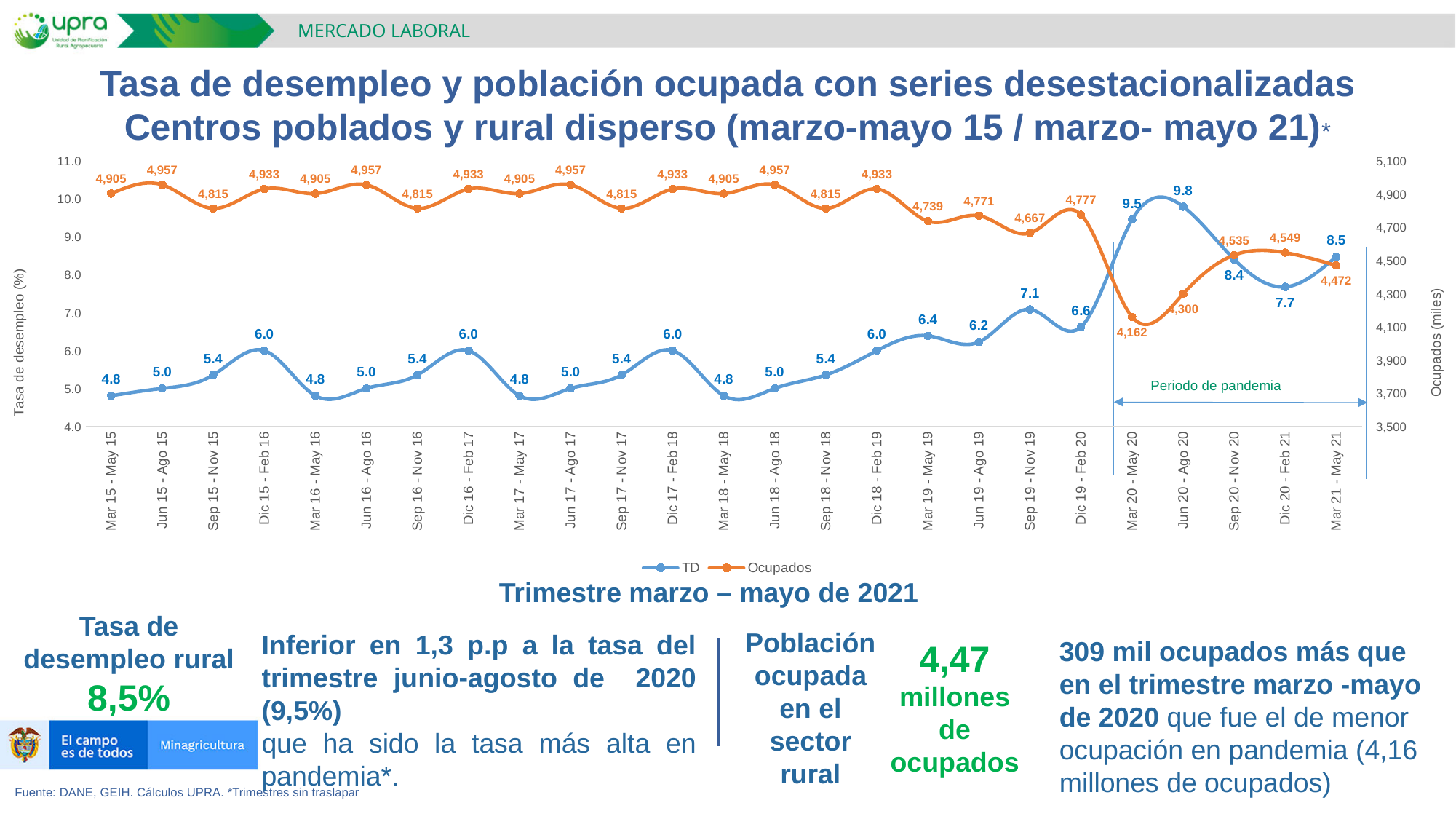
How many series does the legend list? 2 How many periods are plotted along the x axis? 25 In which period is the TD series at its highest? Jun 20 - Ago 20 Does the Ocupados series rise or fall from Mar 20 - May 20 to Dic 20 - Feb 21? Rise What is the difference between the TD value for Jun 20 - Ago 20 and the TD value for Mar 21 - May 21? 1.3 What is the Ocupados value for Mar 20 - May 20? 4,162 What is the Ocupados value for Sep 20 - Nov 20? 4,535 Which period has the larger TD value, Sep 19 - Nov 19 or Dic 19 - Feb 20? Sep 19 - Nov 19 In which period is the Ocupados series at its lowest? Mar 20 - May 20 What is the TD value for Mar 21 - May 21? 8.5 What kind of chart is shown on the slide? Line chart What is the difference between the Ocupados value for Dic 19 - Feb 20 and the Ocupados value for Mar 20 - May 20? 615